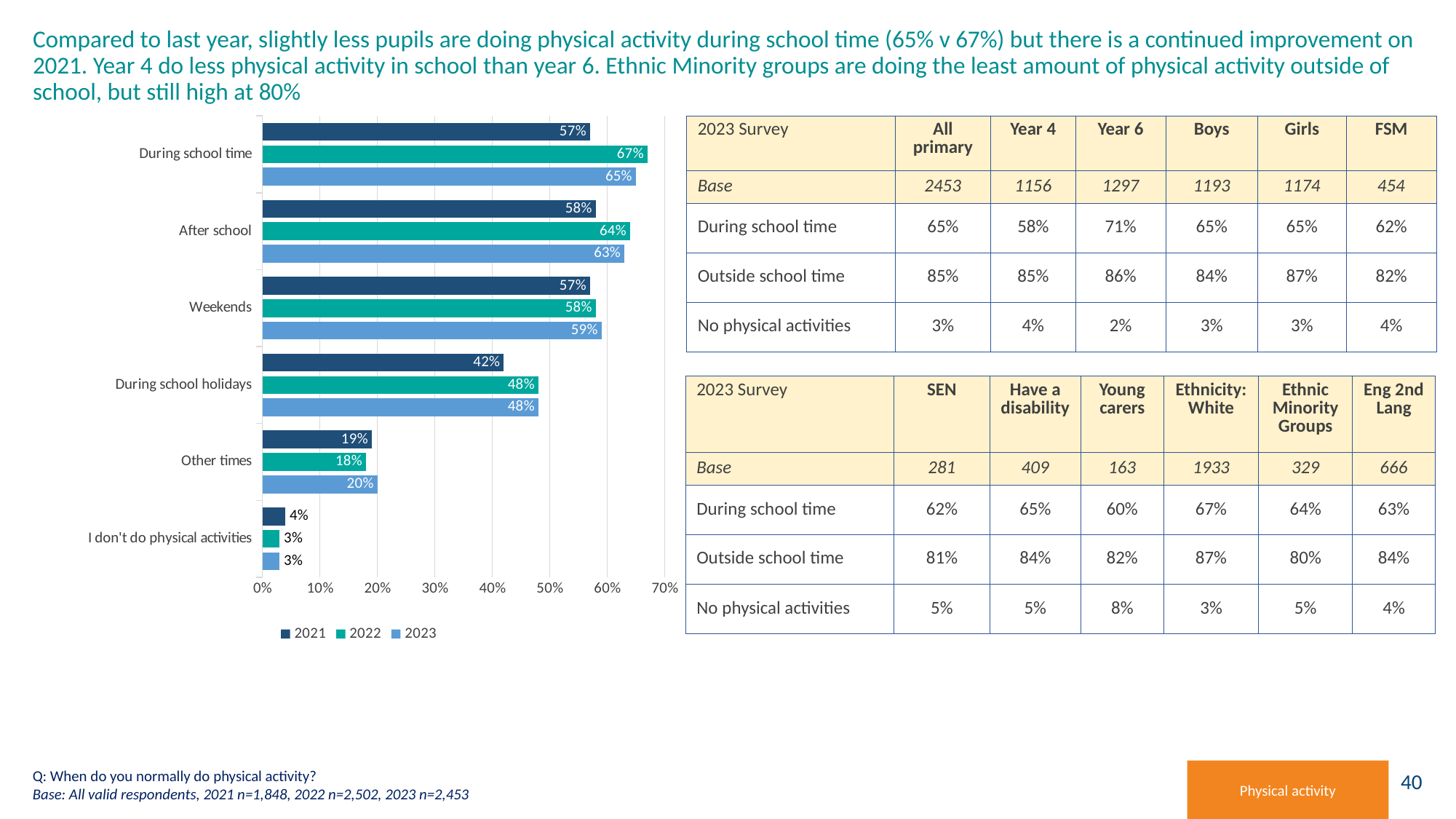
How many series does the legend list? 3 What is the difference between the 2022 and 2021 values for 'During school time'? 10% What is the 2021 value for 'During school holidays'? 42% How many categories are shown on the chart? 6 Which category has the lowest 2023 value? I don't do physical activities What is the 2023 value for 'During school time'? 65% What is the 2022 value for 'After school'? 64% What kind of chart is shown on the slide? Bar chart Which category has the highest 2022 value? During school time Is the 2023 value for 'Weekends' greater or less than 50%? greater Which years are listed in the chart legend? 2021, 2022, 2023 Which is larger for 'Other times': the 2021 value or the 2023 value? 2023